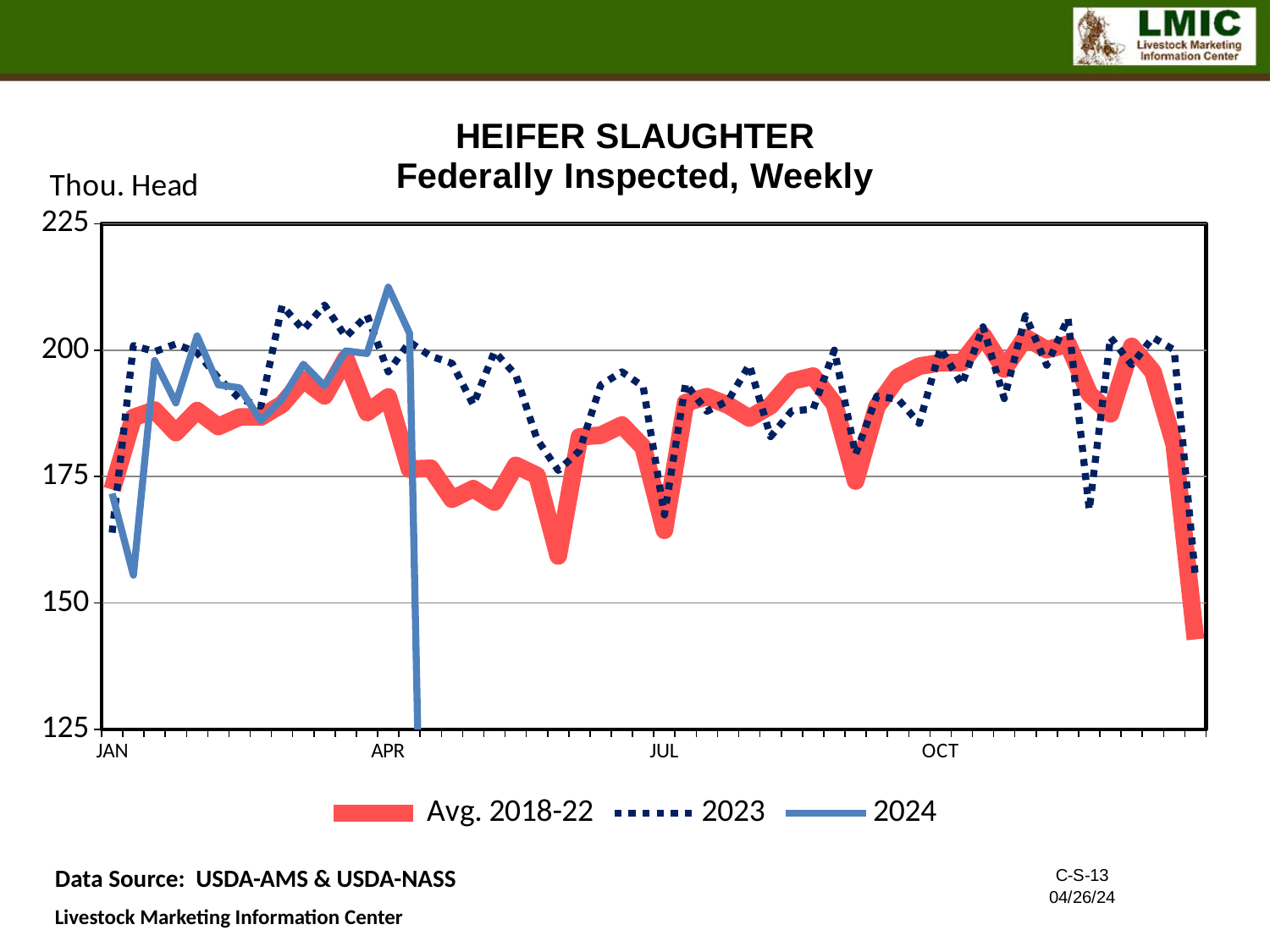
What unit is shown on the y-axis label? Thou. Head Is the lowest value of the Avg. 2018-22 line in June greater or less than 175? less How many series does the legend list? 3 What kind of chart is shown on the slide? line chart At the early April peak, which series is higher: 2024 or Avg. 2018-22? 2024 Is the lowest value of the 2024 line in January greater or less than 175? less Is the peak of the 2023 line in March greater or less than 200? greater Does the Avg. 2018-22 line rise or fall from OCT to the end of the year? fall What is the title of the chart? HEIFER SLAUGHTER Federally Inspected, Weekly At the end of December, which series is higher: 2023 or Avg. 2018-22? 2023